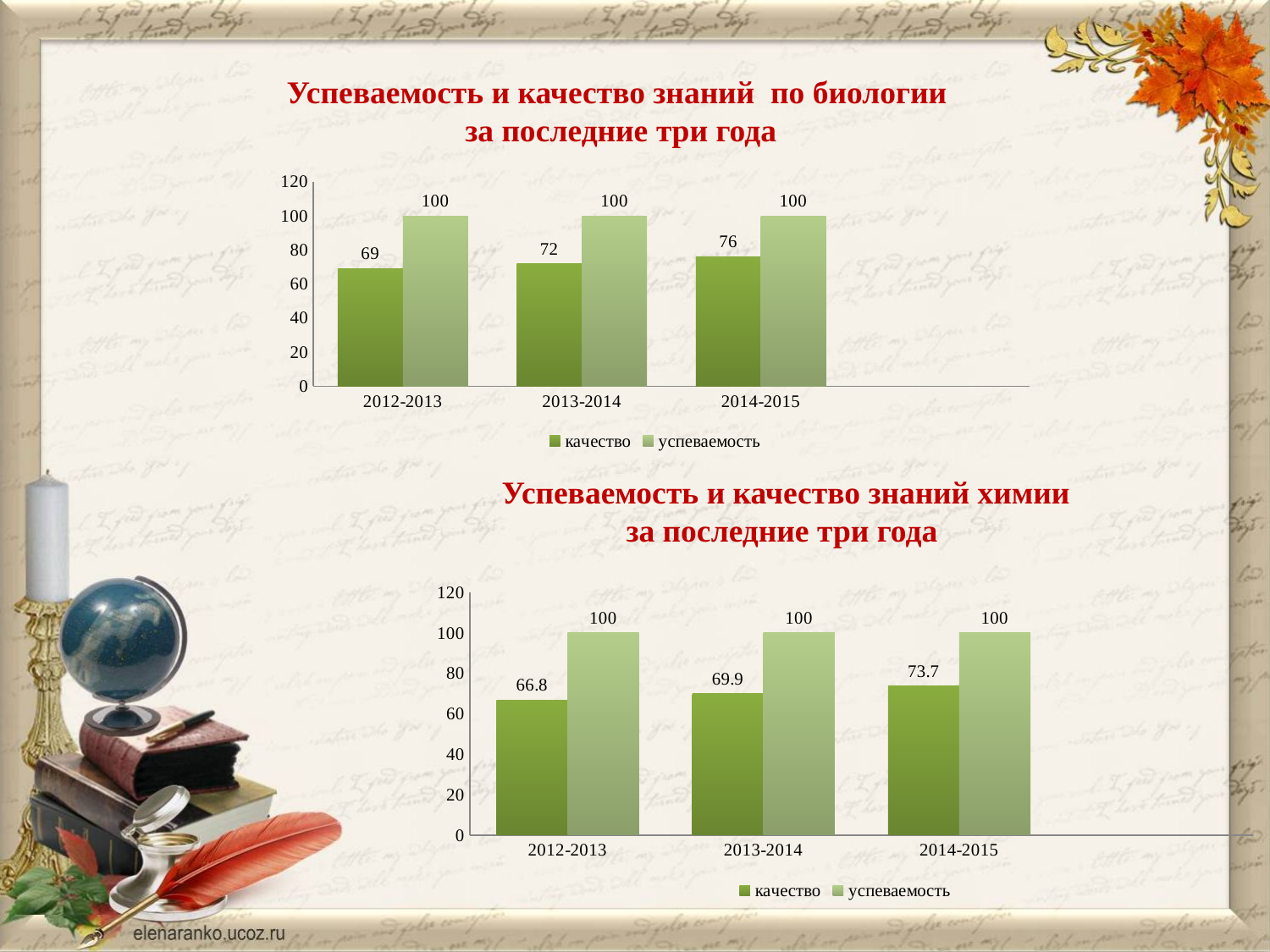
In the biology chart (top), what is the value of качество for 2014-2015? 76 In the chemistry chart (bottom), which year has the lowest качество value? 2012-2013 In the biology chart (top), what is the value of качество for 2012-2013? 69 In the chemistry chart (bottom), what is the value of успеваемость for 2014-2015? 100 What kind of chart is the biology chart (top)? bar chart How many series does the legend of the chemistry chart (bottom) list? 2 In the chemistry chart (bottom), what is the difference between the качество values for 2014-2015 and 2012-2013? 6.9 In the chemistry chart (bottom), which is larger: качество for 2013-2014 or качество for 2014-2015? 2014-2015 How many year categories are shown on the x axis of the biology chart (top)? 3 In the biology chart (top), which year has the highest качество value? 2014-2015 In the chemistry chart (bottom), what is the value of качество for 2013-2014? 69.9 In the biology chart (top), what is the difference between the качество values for 2014-2015 and 2012-2013? 7